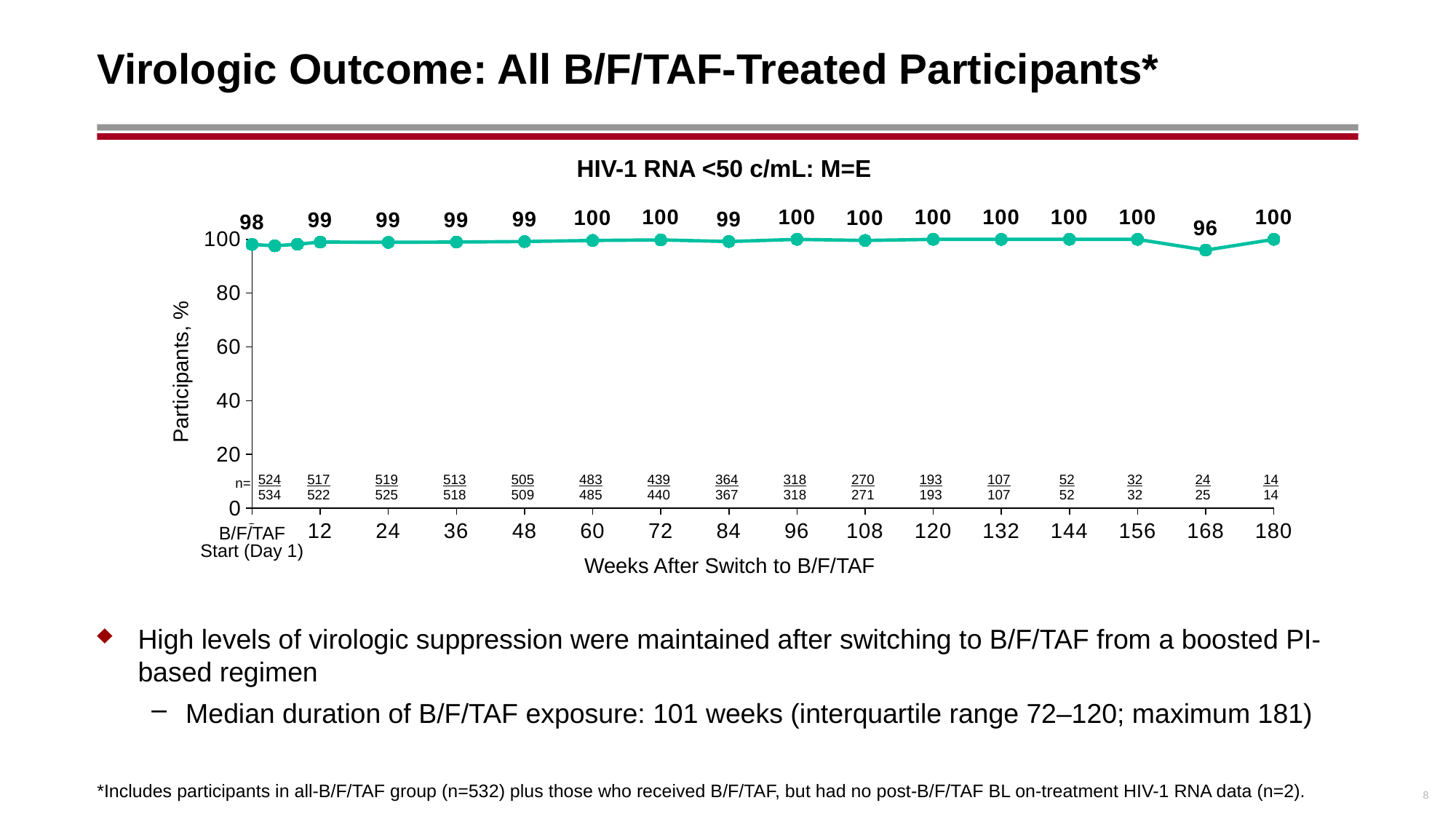
What is the label of the y axis? Participants, % What is the value at week 84? 99 Is the value at week 168 greater or less than 80? greater What is the value at week 168 on the chart? 96 Which is larger, the value at week 168 or the value at week 156? week 156 What is the value at week 180? 100 At which week is the lowest labeled value on the chart? 168 What is the difference between the value at week 180 and the value at week 168? 4 What is the title of the chart? HIV-1 RNA <50 c/mL: M=E What is the difference between the value at week 12 and the value at Day 1? 1 What kind of chart is shown on the slide? line chart What is the value at B/F/TAF Start (Day 1)? 98